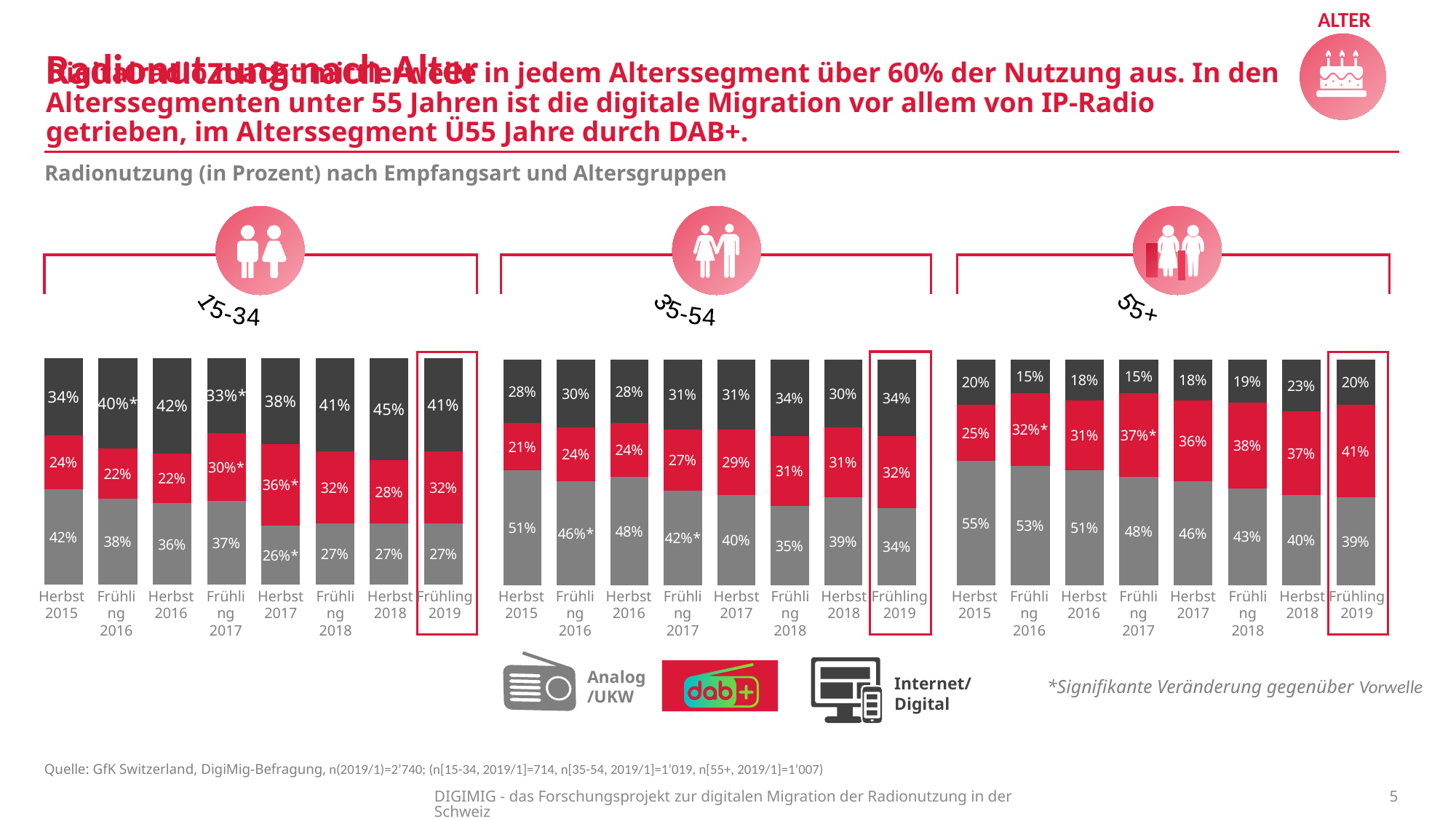
Which age group is shown in the chart on the right of the slide? 55+ What kind of chart is used for the 35-54 age group? Stacked bar chart In the 15-34 chart, what is the Analog/UKW share in Herbst 2015? 42% In the 35-54 chart, what is the difference between the Analog/UKW share in Herbst 2015 and in Frühling 2019? 17 percentage points In the 55+ chart, what is the DAB+ share in Frühling 2019? 41% In the 55+ chart, which is larger in Frühling 2019: the Analog/UKW share or the DAB+ share? DAB+ In the 55+ chart, does the Analog/UKW share rise or fall from Herbst 2015 to Frühling 2019? Fall In the 55+ chart, which period has the lowest Analog/UKW share? Frühling 2019 How many periods are shown on the x axis of the 15-34 chart? 8 In the 35-54 chart, what is the Internet/Digital share in Frühling 2018? 34% In the 15-34 chart, which period has the highest Internet/Digital share? Herbst 2018 How many reception types (series) does the legend list? 3